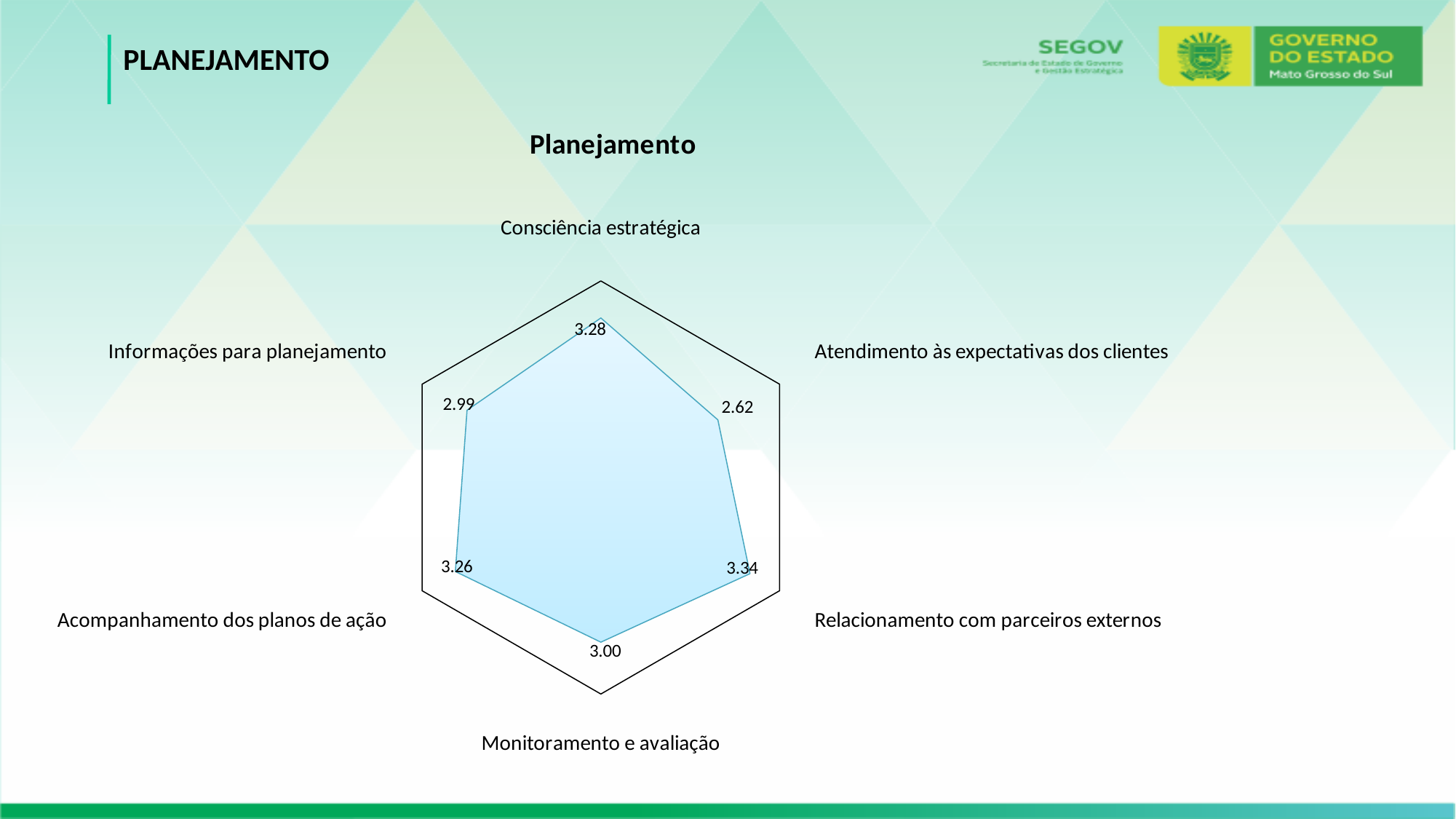
What is the title of the chart? Planejamento How many categories does the radar chart have? 6 Which is larger, the value for Acompanhamento dos planos de ação or the value for Informações para planejamento? Acompanhamento dos planos de ação What is the difference between the values for Relacionamento com parceiros externos and Atendimento às expectativas dos clientes? 0.72 What is the value for Relacionamento com parceiros externos? 3.34 What is the value for Consciência estratégica? 3.28 What is the value for Atendimento às expectativas dos clientes? 2.62 Which category has the lowest value? Atendimento às expectativas dos clientes Which category has the highest value? Relacionamento com parceiros externos What is the value for Informações para planejamento? 2.99 What is the value for Monitoramento e avaliação? 3.00 What type of chart is shown on the slide? Radar chart